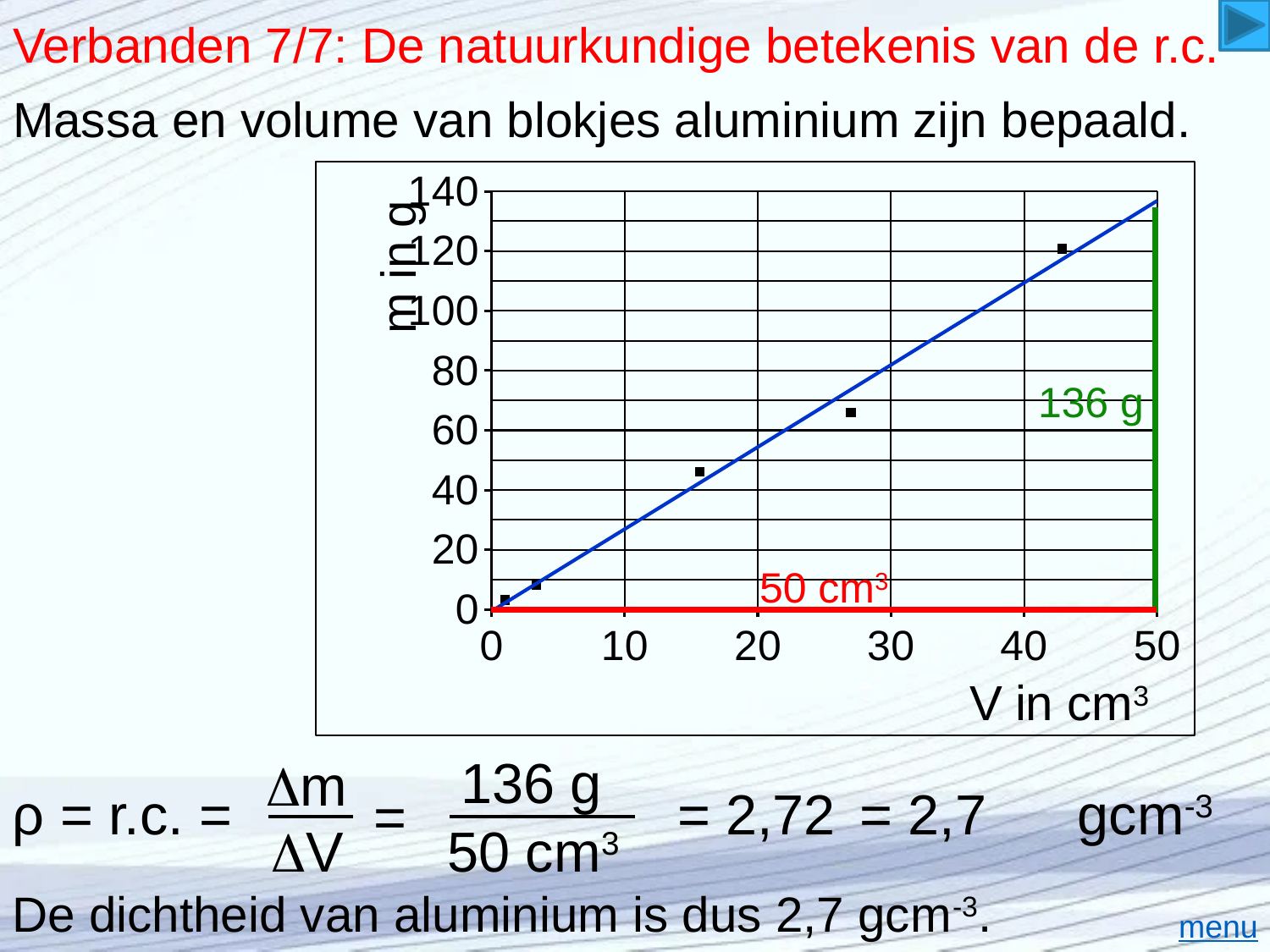
What is the highest value shown on the vertical axis of the chart? 140 Is the mass of the data point plotted at about V = 27 cm³ greater or less than 80 g? less What is the label of the horizontal axis of the chart? V in cm³ Is the mass of the data point plotted at about V = 43 cm³ greater or less than 100 g? greater What volume interval is marked by the red annotation along the x axis? 50 cm³ What is the label of the vertical axis of the chart? m in g Is the mass of the data point plotted at about V = 16 cm³ greater or less than 40 g? greater Which plotted data point has the highest mass: the one at about V = 43 cm³ or the one at about V = 27 cm³? the one at about V = 43 cm³ How many data points are plotted on the chart? 5 According to the green annotation, what mass does the trend line reach at V = 50 cm³? 136 g Do the plotted masses rise or fall as the volume V increases along the x axis? rise What kind of chart is shown on the slide? scatter chart with a trend line